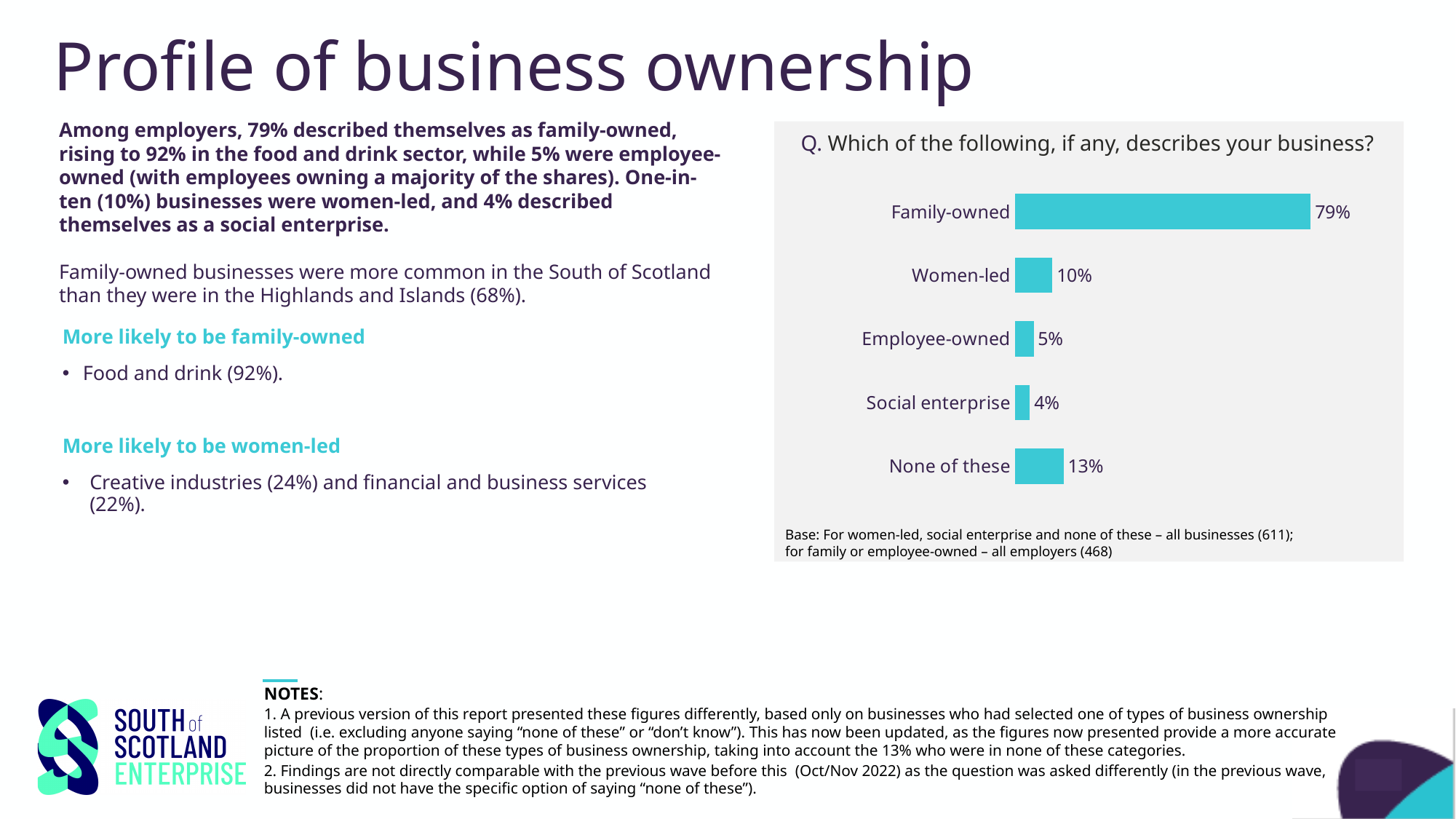
What percentage of businesses described themselves as family-owned? 79% What is the difference between the Family-owned and Women-led values? 69% What value is shown for None of these? 13% Which is larger, the value for Women-led or the value for None of these? None of these What percentage of businesses are employee-owned according to the chart? 5% Which category has the lowest value in the chart? Social enterprise What question is shown as the title of the chart? Q. Which of the following, if any, describes your business? Which category has the highest value in the chart? Family-owned What is the difference between the None of these and Social enterprise values? 9% How many categories are shown in the chart? 5 What is the value shown for Women-led? 10% What type of chart is shown on the slide? Bar chart